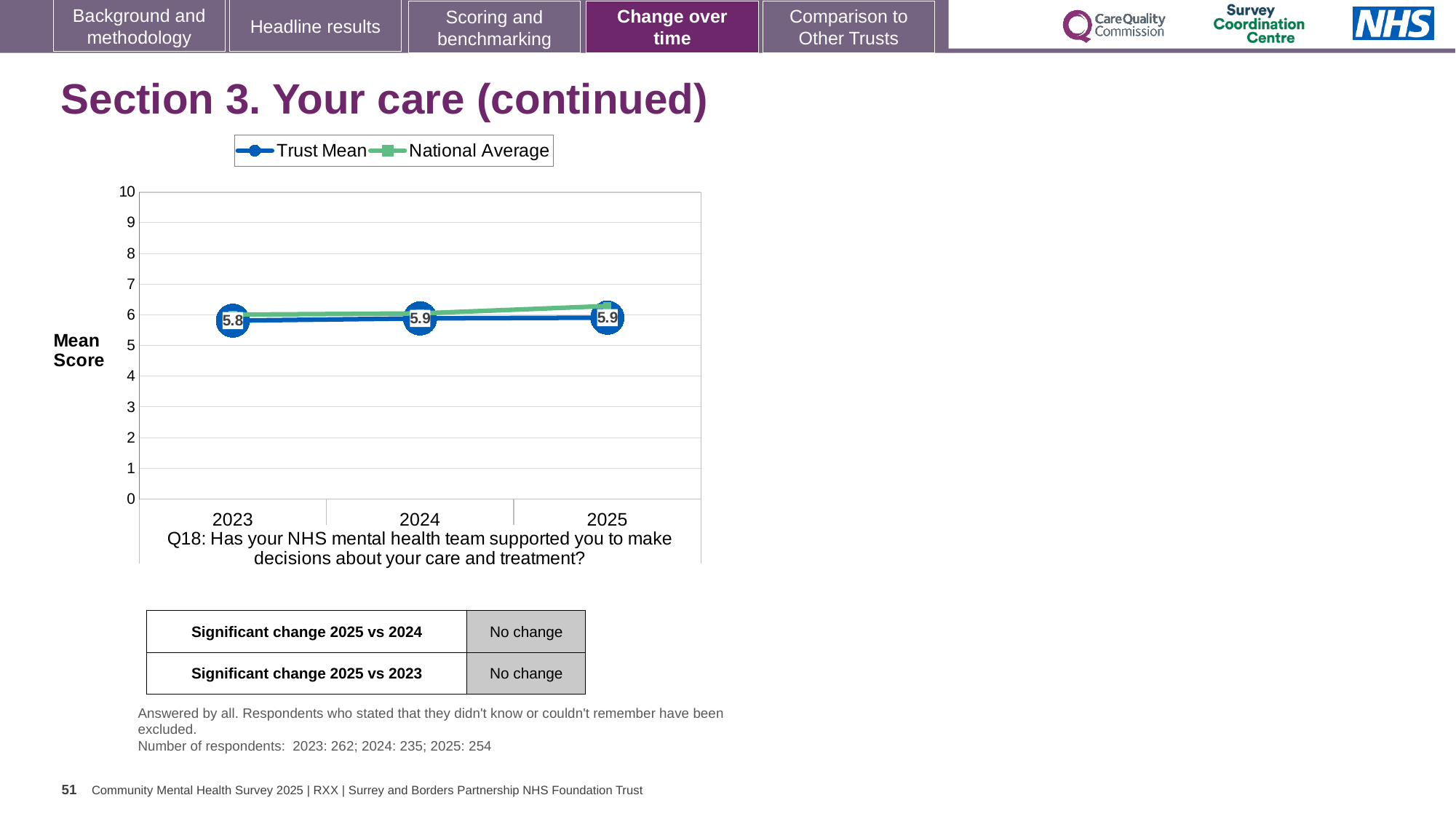
How many series does the legend list? 2 What is the Trust Mean score for 2024? 5.9 What kind of chart is shown on the slide? Line chart What is the Trust Mean score for 2023? 5.8 Does the Trust Mean score rise or fall from 2023 to 2025? Rise Which is larger, the Trust Mean score for 2023 or for 2025? 2025 What are the two series named in the legend? Trust Mean and National Average What is the Trust Mean score for 2025? 5.9 How many years are plotted on the x axis? 3 In which year is the Trust Mean score lowest? 2023 Is the National Average value for 2025 greater or less than 7? less What is the difference between the Trust Mean score in 2025 and in 2023? 0.1